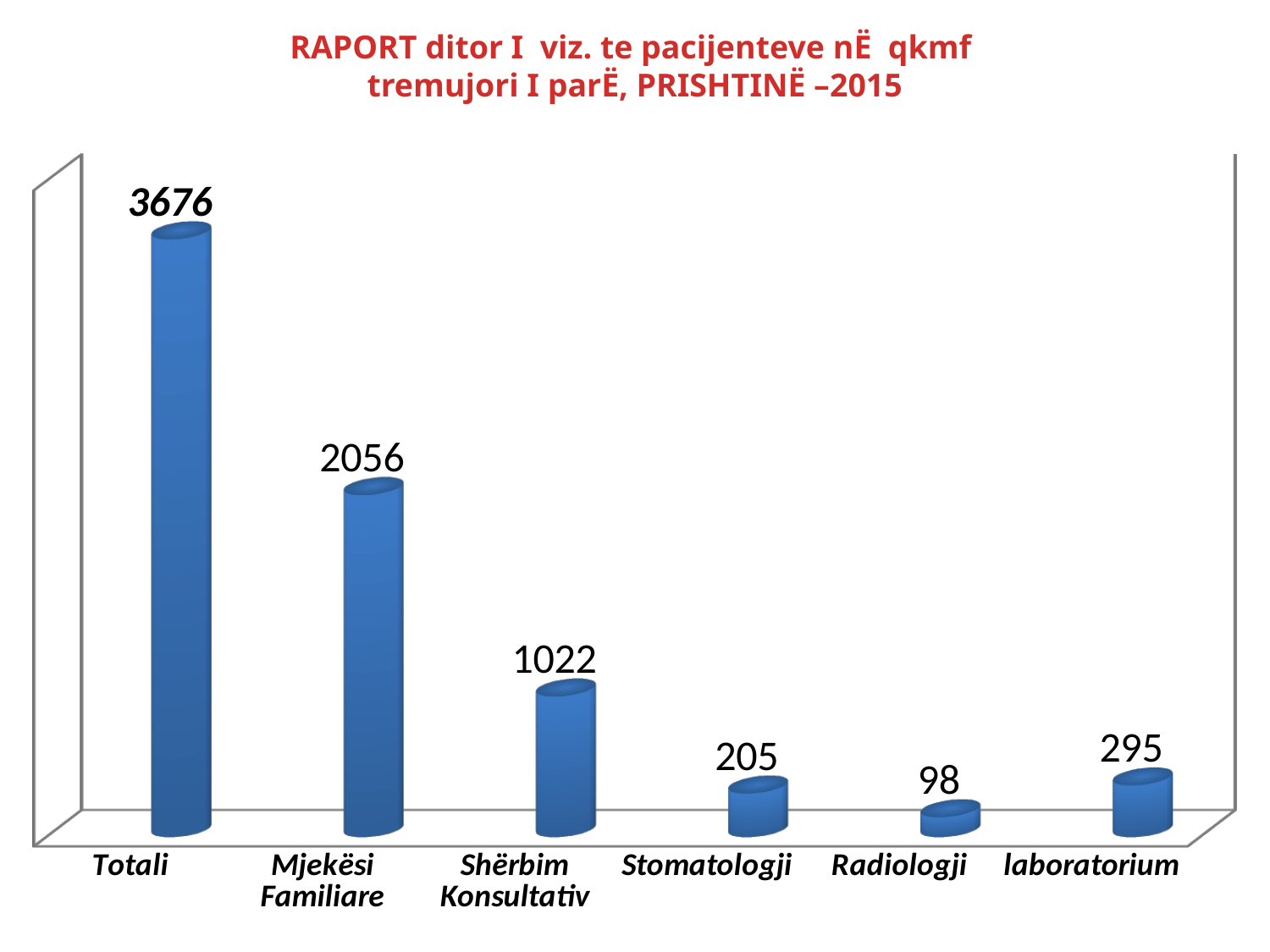
What is the value for Totali? 3676 How many categories are shown on the x axis? 6 What is the difference between the values for laboratorium and Stomatologji? 90 What is the value for Radiologji? 98 What is the difference between the values for Mjekësi Familiare and Shërbim Konsultativ? 1034 What is the value for Mjekësi Familiare? 2056 Which category has the highest value? Totali What is the value for laboratorium? 295 What kind of chart is shown on the slide? Bar chart Which is larger, the value for Stomatologji or the value for laboratorium? laboratorium Which category has the lowest value? Radiologji What is the value for Shërbim Konsultativ? 1022